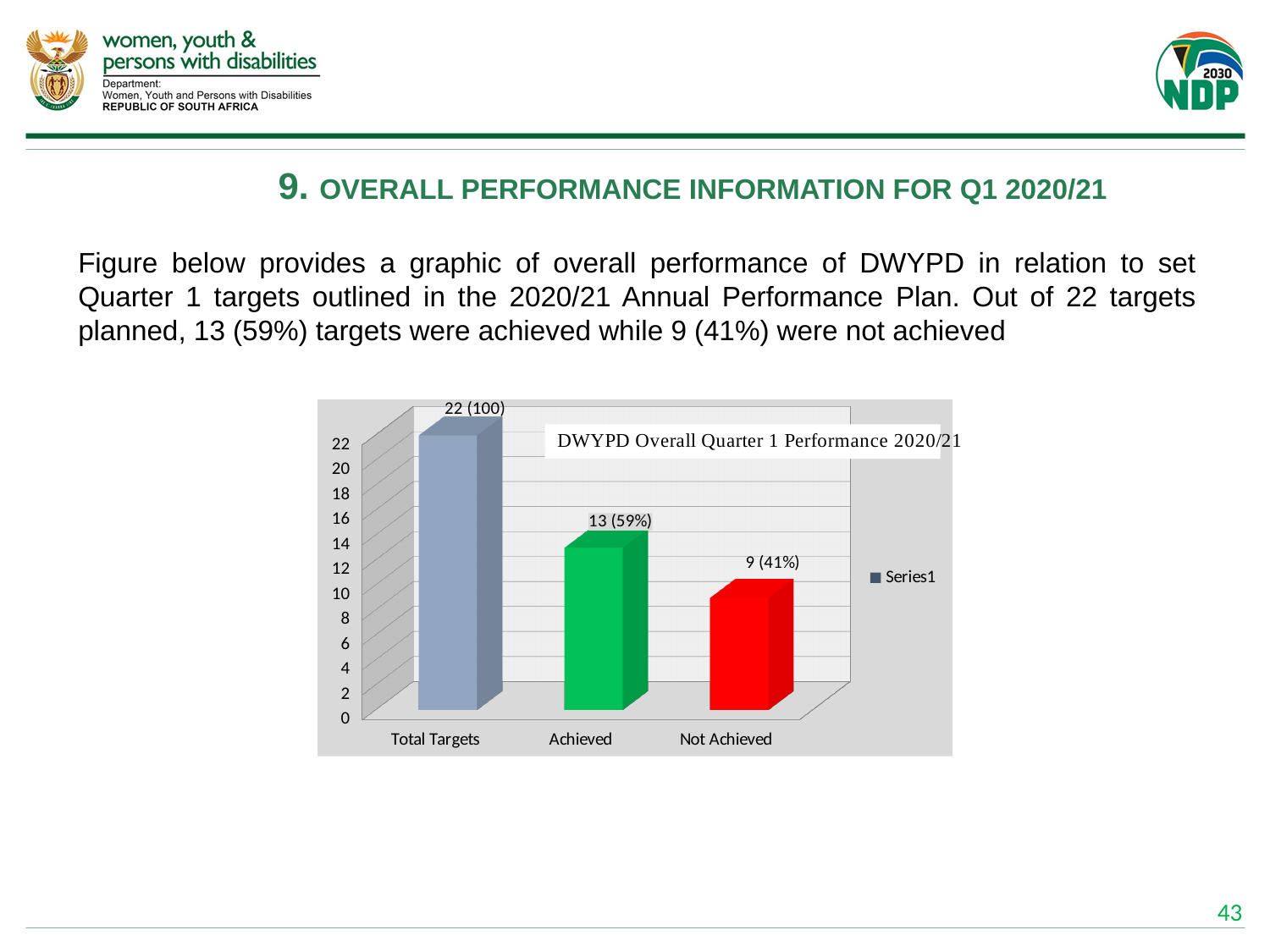
Which category has the lowest value? Not Achieved Is the value for Not Achieved greater or less than 10? less Which is larger, the value for Achieved or the value for Not Achieved? Achieved What kind of chart is shown on the slide? bar chart What is the data label shown for Not Achieved? 9 (41%) What is the data label shown for Achieved? 13 (59%) What is the data label shown for Total Targets? 22 (100) What is the difference between the number of targets Achieved and Not Achieved? 4 How many categories are shown on the x axis? 3 What is the title of the chart? DWYPD Overall Quarter 1 Performance 2020/21 How many series does the legend list? 1 Which category has the highest value? Total Targets